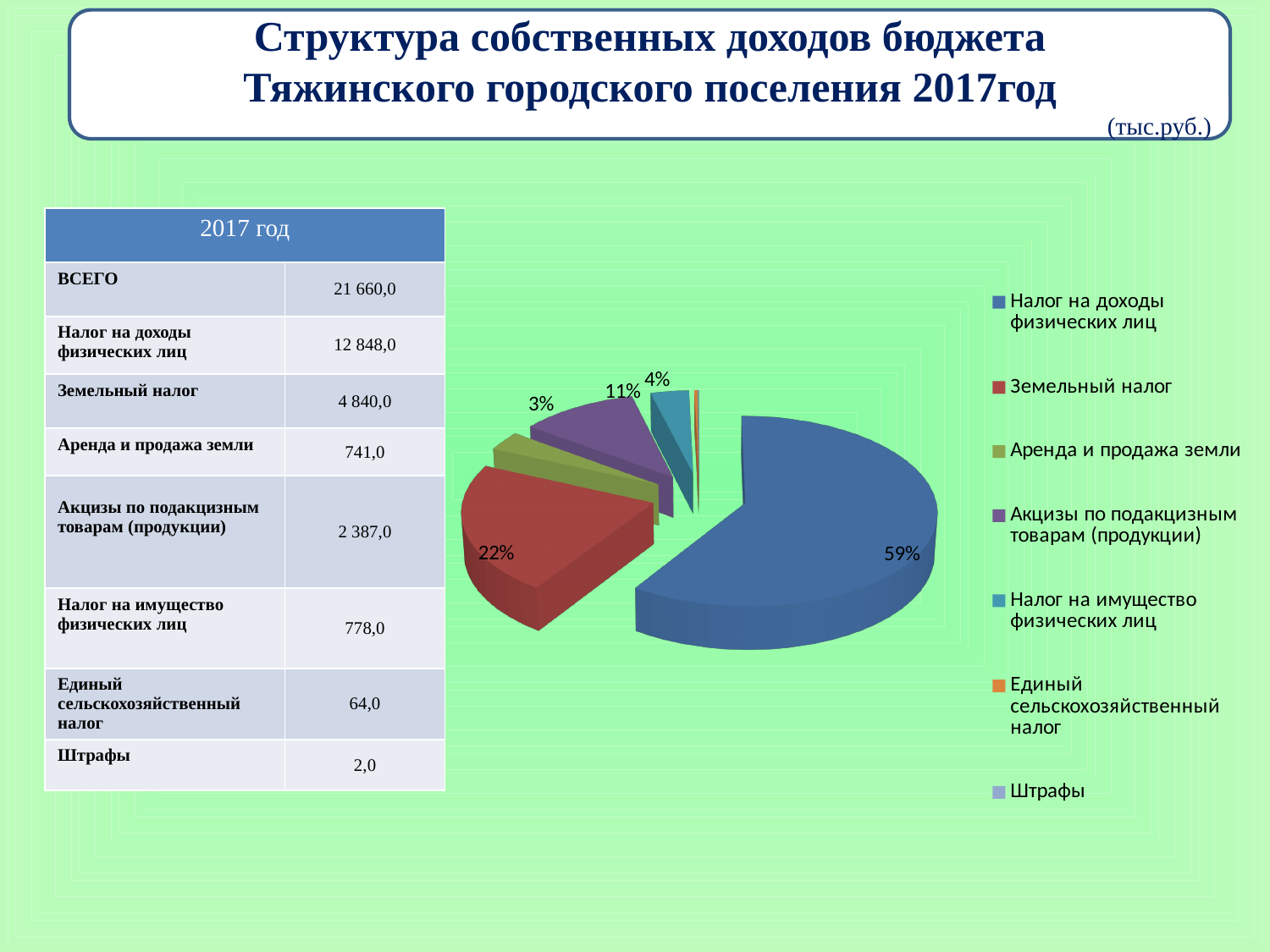
Which slice is larger: Земельный налог or Акцизы по подакцизным товарам (продукции)? Земельный налог How many entries does the chart legend list? 7 What kind of chart is shown on the slide? Pie chart Which colour represents Земельный налог in the pie chart? Red By how many percentage points does the Налог на доходы физических лиц slice exceed the Земельный налог slice? 37 What share of the pie does Акцизы по подакцизным товарам (продукции) take? 11% Which category has the largest slice of the pie? Налог на доходы физических лиц What share of the pie does Налог на доходы физических лиц take? 59% What share of the pie does Налог на имущество физических лиц take? 4% Which legend entry is shown in orange? Единый сельскохозяйственный налог